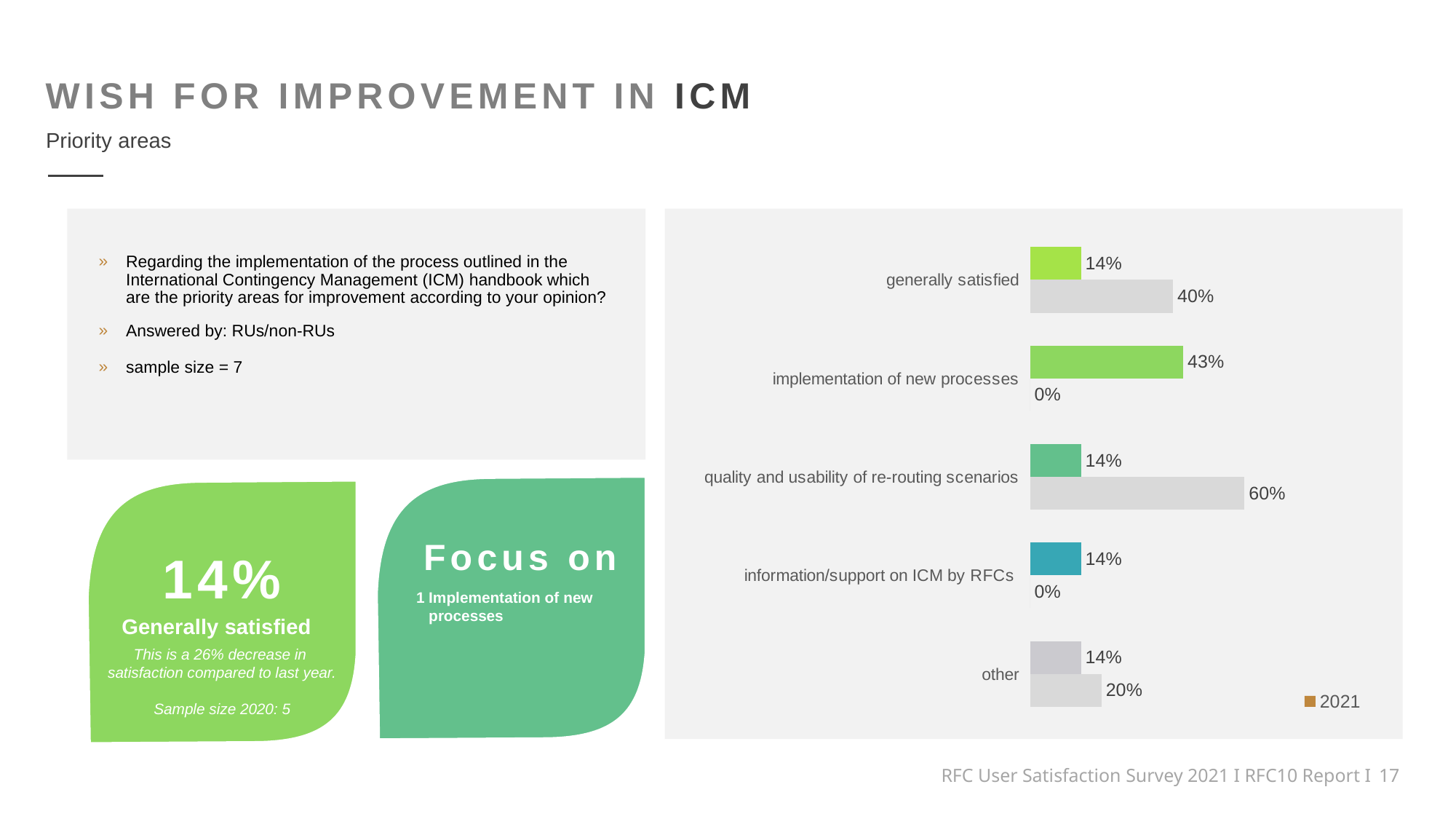
How many categories does the bar chart show? 5 What is the difference between the 2021 value and the grey-bar value for 'quality and usability of re-routing scenarios'? 46% What is the value of the grey bar for 'quality and usability of re-routing scenarios'? 60% Which category has the highest 2021 value? implementation of new processes What is the only entry shown in the chart legend? 2021 What kind of chart is shown on the slide? bar chart What is the 2021 value for 'generally satisfied'? 14% What is the value of the grey bar for 'generally satisfied'? 40% Which category has the highest grey-bar value? quality and usability of re-routing scenarios What is the 2021 value for 'implementation of new processes'? 43% How many series does the chart legend list? 1